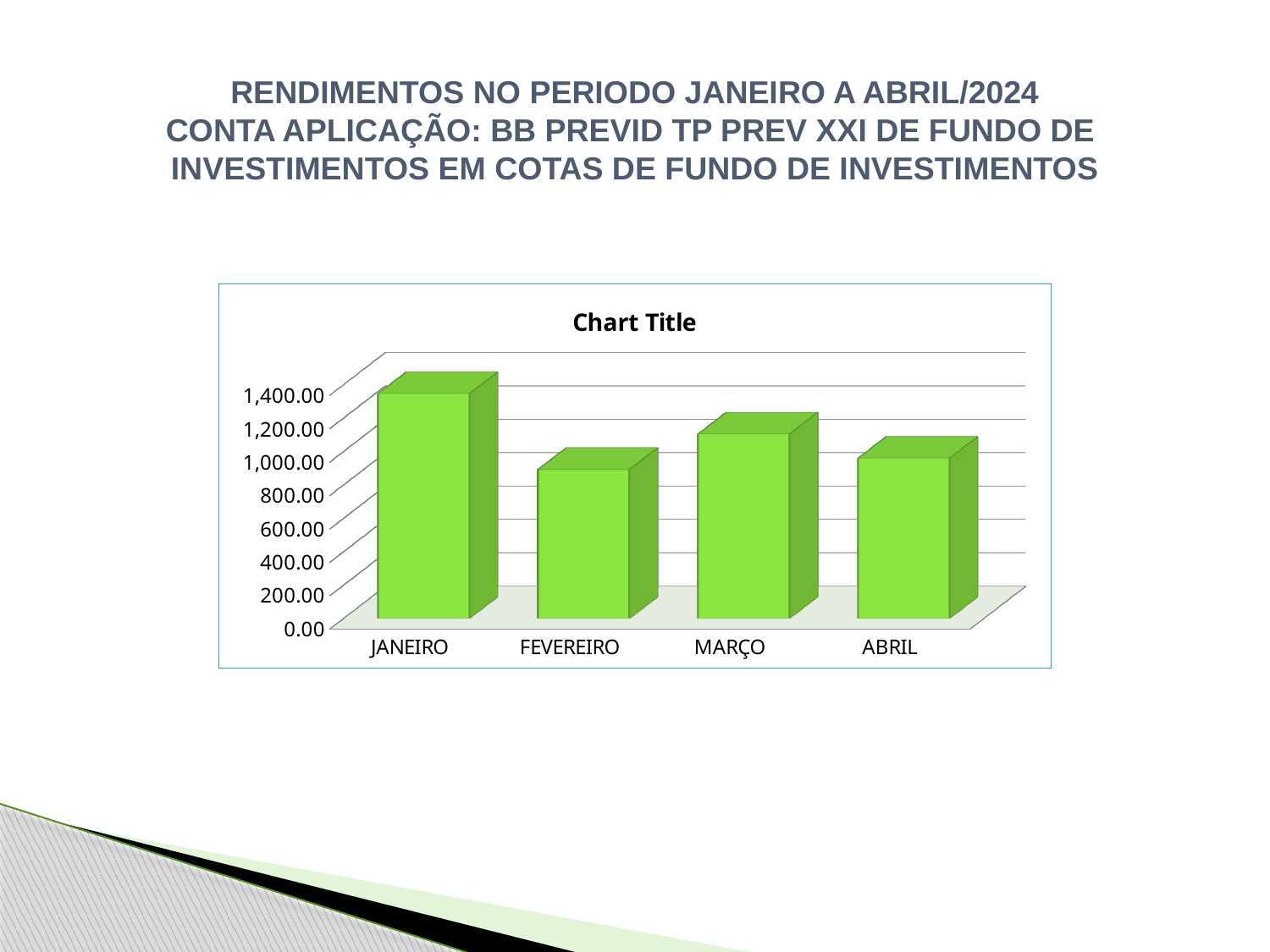
Is the value for FEVEREIRO greater or less than 800.00? greater Is the value for MARÇO greater or less than 1,000.00? greater Does the value rise or fall from JANEIRO to FEVEREIRO? fall Which is larger, the value for FEVEREIRO or the value for MARÇO? MARÇO Which is larger, the value for MARÇO or the value for ABRIL? MARÇO What kind of chart is shown on the slide? bar chart How many months (categories) are plotted on the chart? 4 Which month has the highest value on the chart? JANEIRO What title is printed above the chart's plot area? Chart Title Is the value for FEVEREIRO greater or less than 1,200.00? less